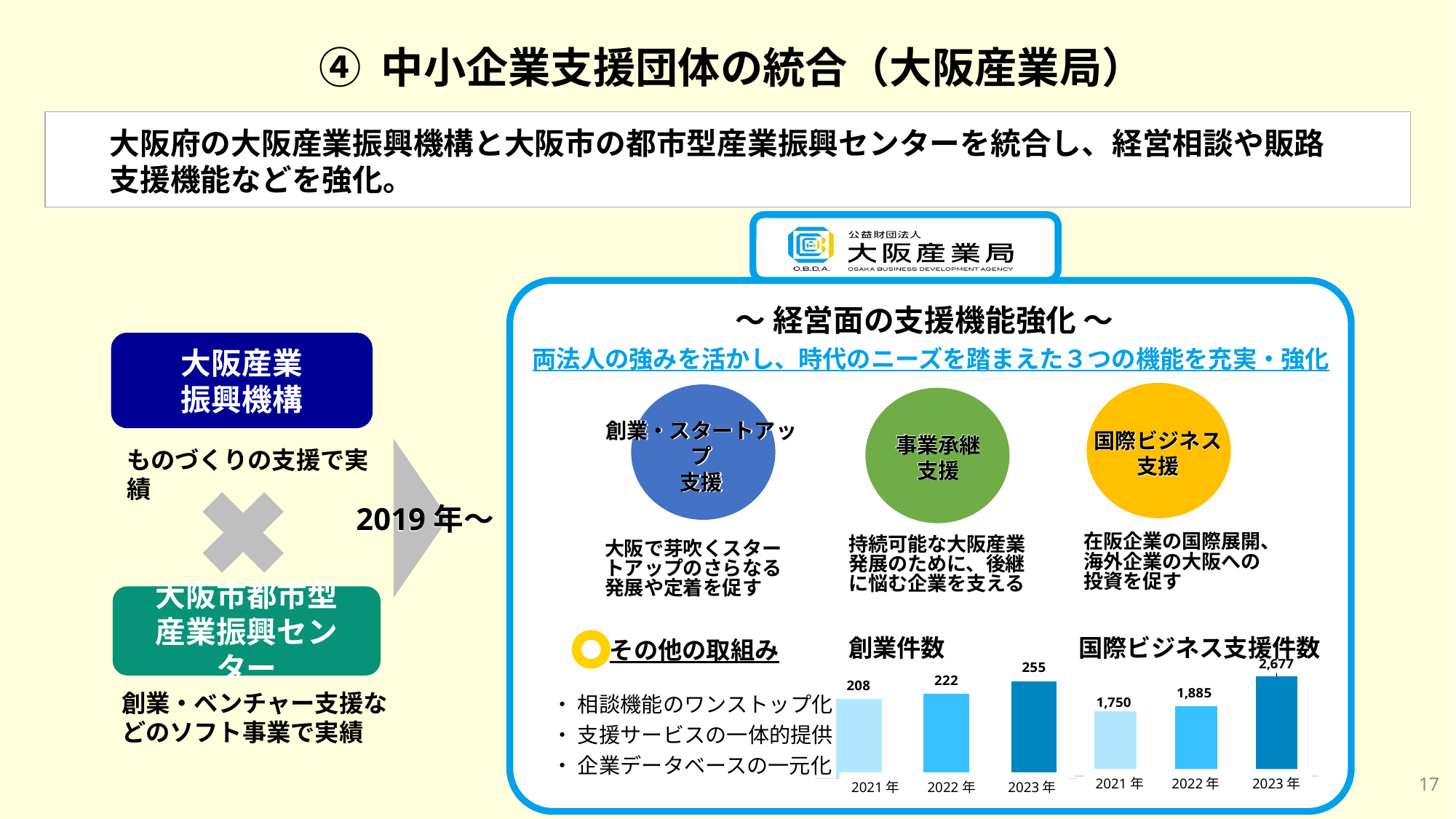
In the 国際ビジネス支援件数 chart, what is the value for 2022年? 1,885 What kind of chart is the 創業件数 chart? bar chart In the 創業件数 chart, which year has the highest value? 2023年 How many years are shown in the 国際ビジネス支援件数 chart? 3 In the 国際ビジネス支援件数 chart, do the values rise or fall from 2021年 to 2023年? rise In the 創業件数 chart, what is the value for 2023年? 255 In the 国際ビジネス支援件数 chart, which year has the lowest value? 2021年 In the 創業件数 chart, what is the difference between the 2023年 and 2022年 values? 33 In the 国際ビジネス支援件数 chart, what is the difference between the 2023年 and 2021年 values? 927 In the 創業件数 chart, what is the value for 2021年? 208 In the 国際ビジネス支援件数 chart, what is the value for 2023年? 2,677 In the 創業件数 chart, which is larger, the value for 2021年 or 2022年? 2022年